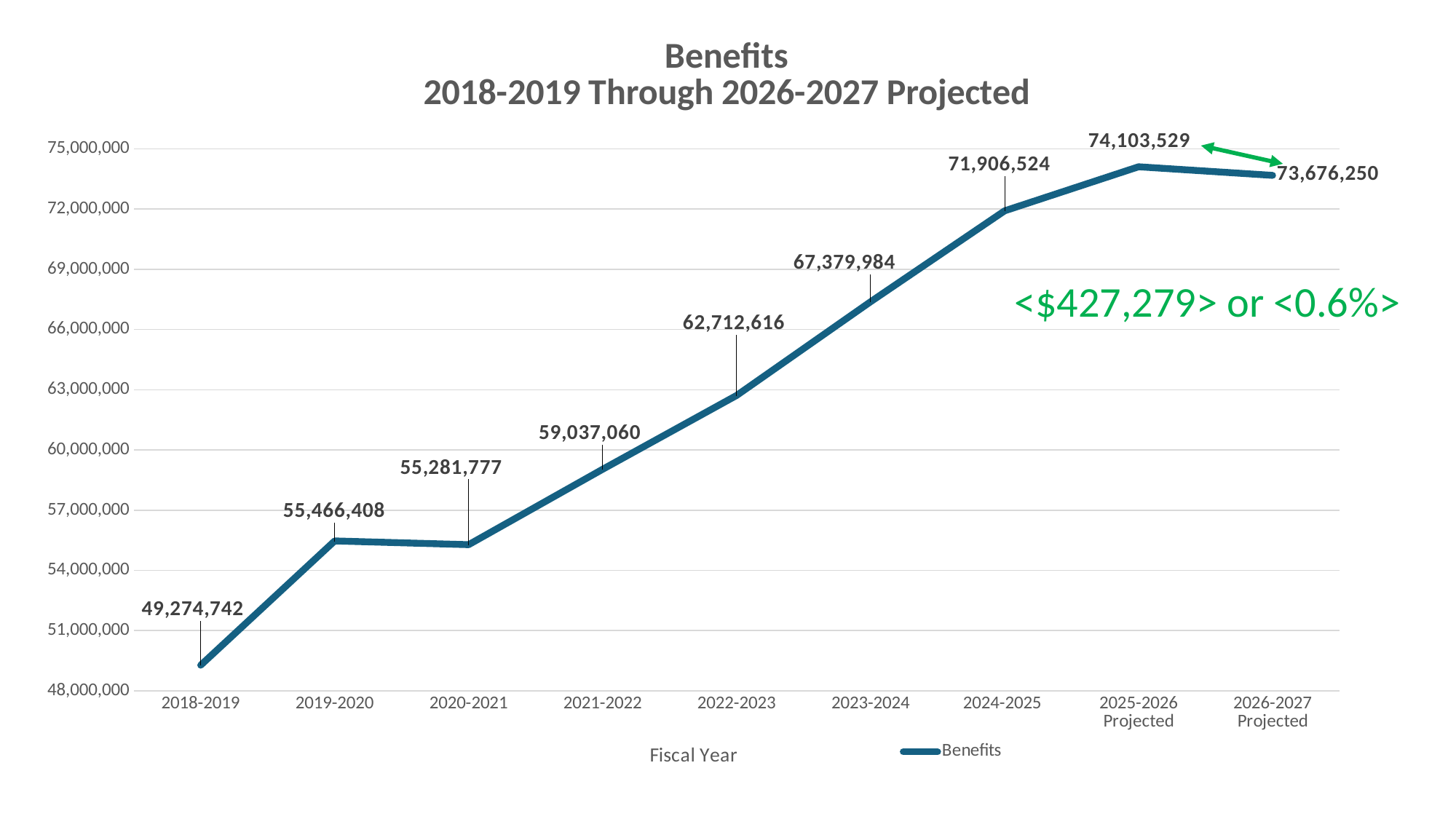
Do the Benefits values generally rise or fall from 2018-2019 to 2025-2026 Projected? Rise What is the Benefits value for 2018-2019? 49,274,742 What is the Benefits value for 2022-2023? 62,712,616 What is the projected Benefits value for 2026-2027? 73,676,250 How many series does the legend list? 1 Which fiscal year has the highest Benefits value? 2025-2026 Projected What kind of chart is shown on the slide? Line chart Which is larger, the Benefits value for 2019-2020 or for 2020-2021? 2019-2020 Which fiscal year has the lowest Benefits value? 2018-2019 How many fiscal years are plotted on the chart? 9 What is the difference between the Benefits values for 2024-2025 and 2023-2024? 4,526,540 What is the difference between the 2025-2026 Projected and 2026-2027 Projected Benefits values? 427,279